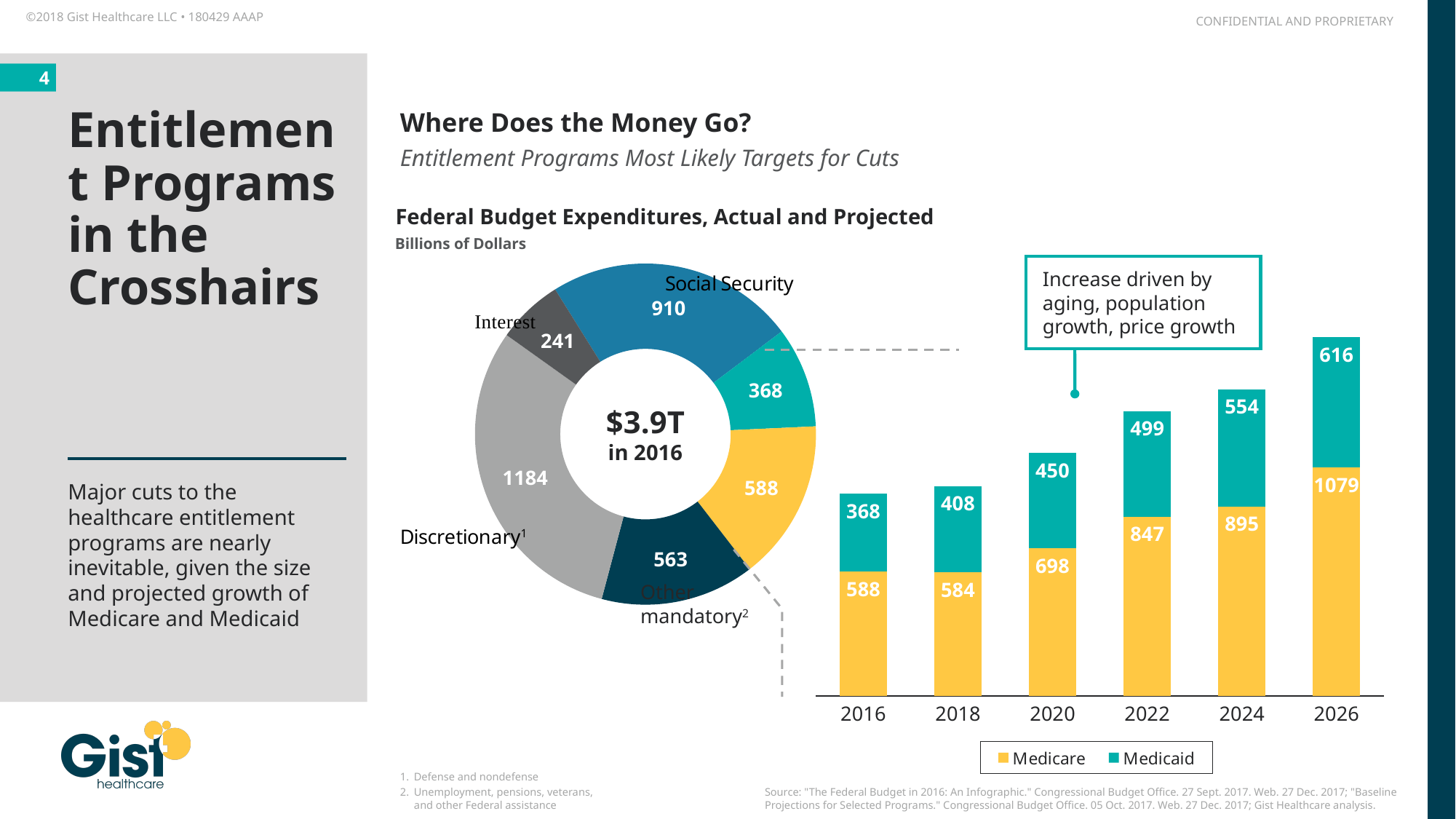
In the stacked bar chart, what is the Medicare value for 2020? 698 In the stacked bar chart, how many years are shown on the x axis? 6 In the stacked bar chart, what is the total of the 2024 bar? 1449 In the stacked bar chart, what is the Medicaid value for 2026? 616 In the donut chart, what is the value for Discretionary? 1184 In the donut chart, what total is shown in the center? $3.9T in 2016 In the donut chart, which labeled segment has the smallest value? Interest In the donut chart, what is the value for Social Security? 910 In the stacked bar chart, how many series does the legend list? 2 In the stacked bar chart, does Medicare spending rise or fall from 2016 to 2026? rise In the stacked bar chart, which is larger: Medicaid in 2022 or Medicaid in 2018? Medicaid in 2022 In the donut chart, what is the difference between Social Security and Other mandatory? 347